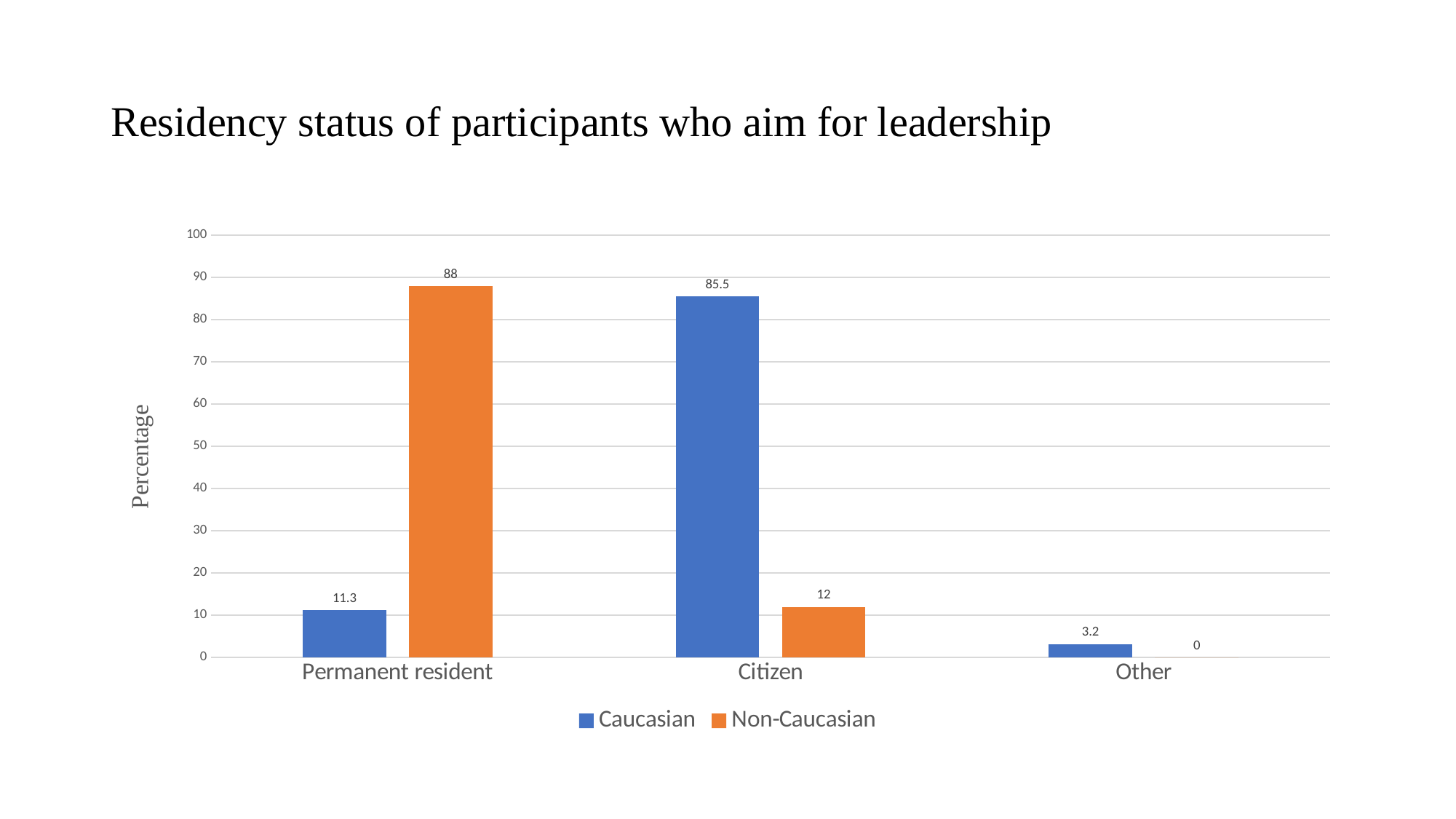
What is the Caucasian value for Permanent resident? 11.3 Which residency status has the lowest Non-Caucasian value? Other How many residency status categories are shown on the x axis? 3 What is the Non-Caucasian value for Other? 0 Which residency status has the highest Caucasian value? Citizen What kind of chart is shown on the slide? Bar chart How many series does the legend list? 2 What is the difference between the Non-Caucasian and Caucasian values for Permanent resident? 76.7 What is the label of the vertical axis? Percentage What is the Caucasian value for Citizen? 85.5 What is the Non-Caucasian value for Permanent resident? 88 Which is larger for Citizen, the Caucasian value or the Non-Caucasian value? Caucasian